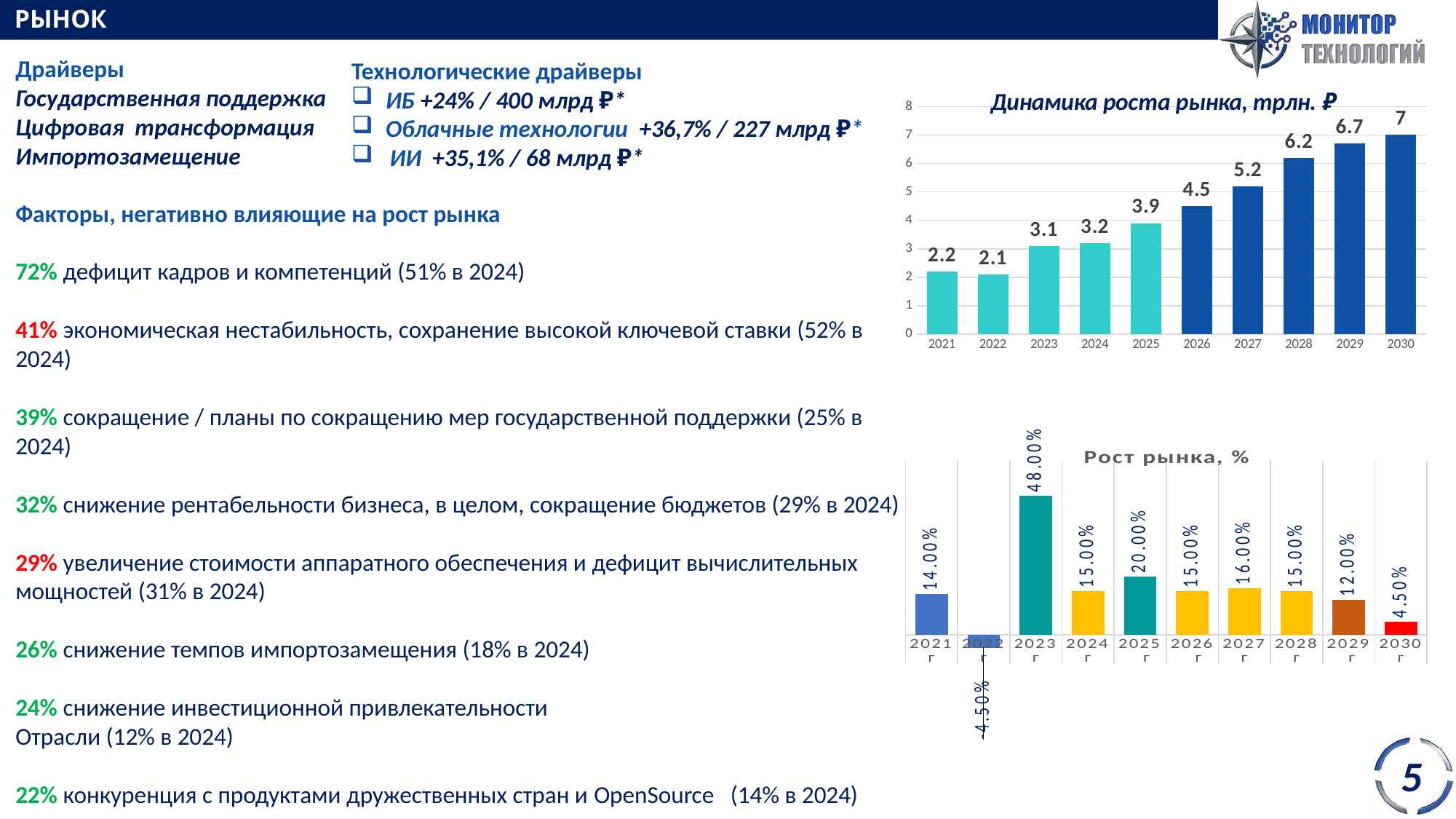
In the chart titled "Рост рынка, %", which year has the highest value? 2023 In the chart titled "Рост рынка, %", which is larger, the value for 2025 or the value for 2029? 2025 In the chart titled "Динамика роста рынка, трлн. ₽", what is the difference between the values for 2030 and 2021? 4.8 In the chart titled "Рост рынка, %", what is the difference between the values for 2027 and 2030? 11.50% In the chart titled "Динамика роста рынка, трлн. ₽", how many years are shown on the x axis? 10 What type of chart is "Динамика роста рынка, трлн. ₽"? bar chart In the chart titled "Динамика роста рынка, трлн. ₽", which year has the lowest value? 2022 In the chart titled "Динамика роста рынка, трлн. ₽", what is the value for 2030? 7 In the chart titled "Рост рынка, %", what is the value for 2022? -4.50% In the chart titled "Динамика роста рынка, трлн. ₽", do the values generally rise or fall from 2023 to 2030? rise In the chart titled "Рост рынка, %", what is the value for 2023? 48.00% In the chart titled "Динамика роста рынка, трлн. ₽", what is the value for 2025? 3.9